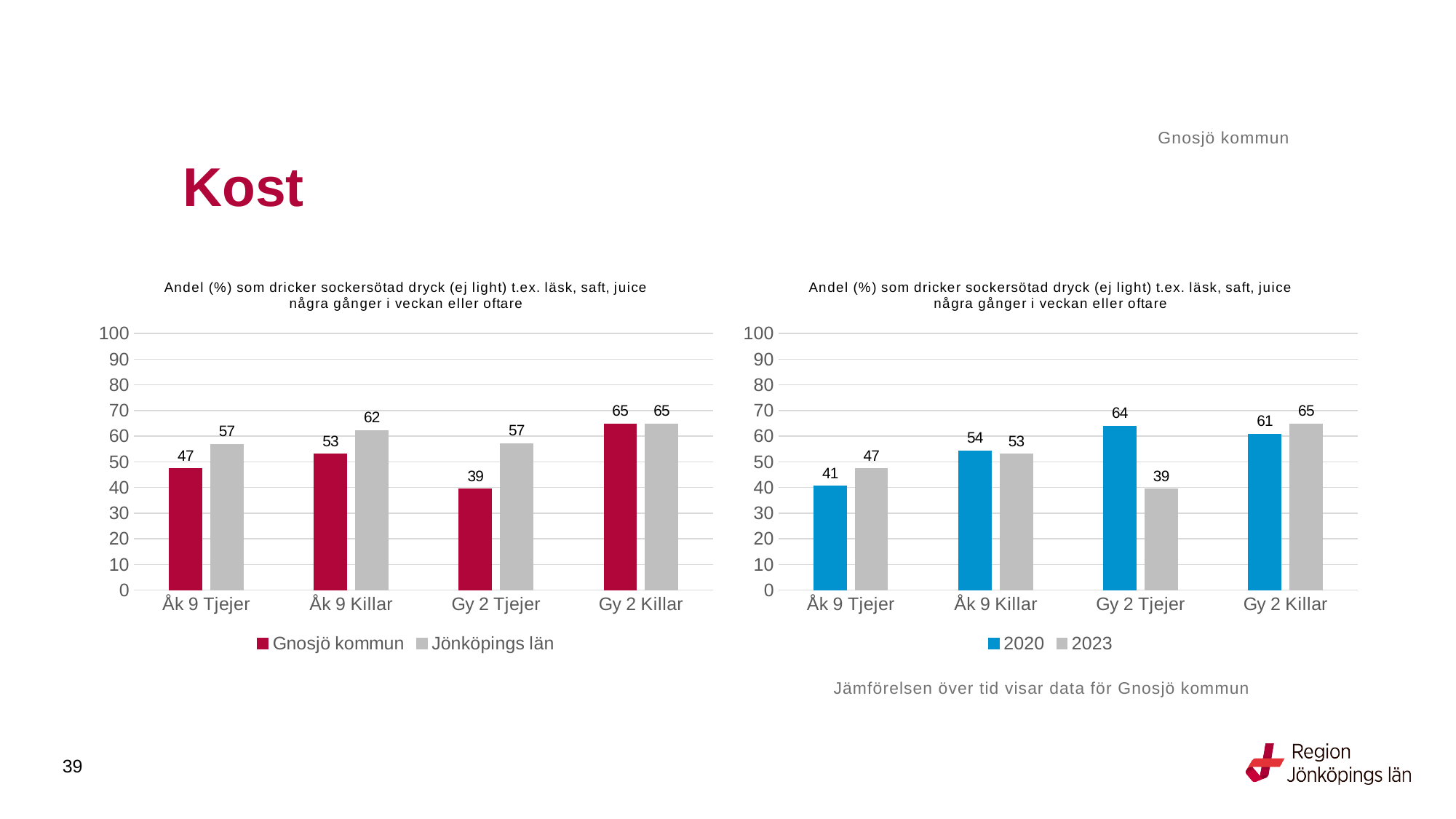
In the left chart, which category has the lowest value for Gnosjö kommun? Gy 2 Tjejer In the right chart, which category has the highest value for 2023? Gy 2 Killar In the right chart, which is larger for Gy 2 Tjejer, the 2020 value or the 2023 value? 2020 In the left chart, what is the value for Gnosjö kommun for Åk 9 Tjejer? 47 In the left chart, what is the value for Jönköpings län for Åk 9 Killar? 62 What type of chart is the left chart? Bar chart In the right chart, what is the difference between the 2020 and 2023 values for Gy 2 Tjejer? 25 How many categories are shown on the x axis of the right chart? 4 In the left chart, how many series does the legend list? 2 In the left chart, what is the difference between Jönköpings län and Gnosjö kommun for Gy 2 Tjejer? 18 In the right chart, what is the value for 2020 for Gy 2 Tjejer? 64 In the right chart, what is the value for 2023 for Åk 9 Tjejer? 47